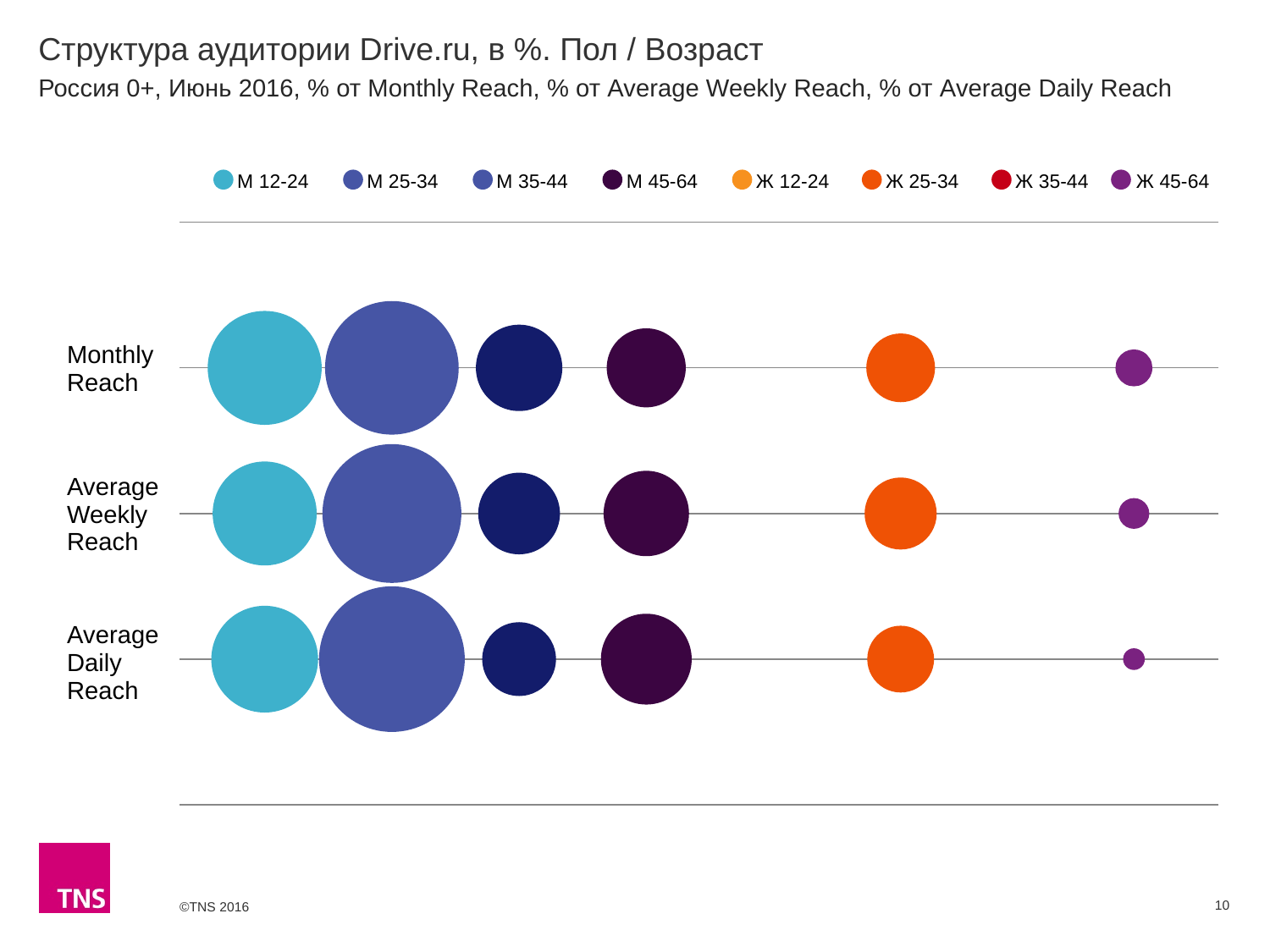
Which series has the largest bubble in the Average Daily Reach row? М 25-34 Which series has the largest bubble in the Monthly Reach row? М 25-34 In the Average Weekly Reach row, which bubble is larger: М 12-24 or М 35-44? М 12-24 Which series has the smallest visible bubble in the Average Daily Reach row? Ж 45-64 How many series does the legend list? 8 What kind of chart is shown on the slide? Bubble chart What is the label of the first (leftmost) legend entry? М 12-24 In the Average Daily Reach row, which bubble is larger: М 25-34 or М 45-64? М 25-34 In the Monthly Reach row, which bubble is larger: Ж 25-34 or Ж 45-64? Ж 25-34 What is the title of the chart on the slide? Структура аудитории Drive.ru, в %. Пол / Возраст How many reach categories (rows) are plotted on the chart? 3